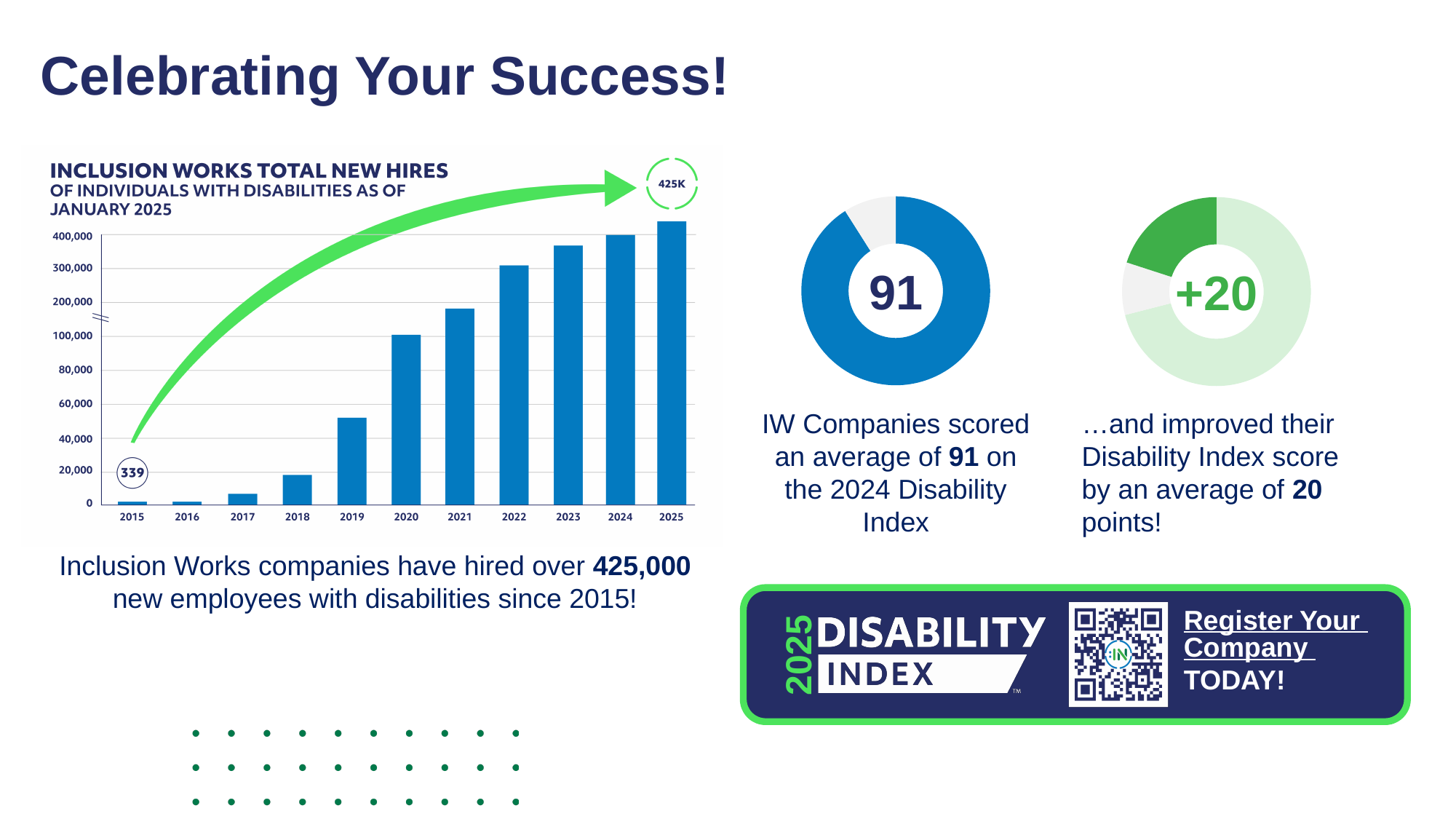
In the 'Inclusion Works Total New Hires' bar chart, is the value for 2018 greater or less than 20,000? less In the 'Inclusion Works Total New Hires' bar chart, what value is labelled for 2015? 339 What number is shown in the centre of the green donut chart on the right of the slide? +20 In the 'Inclusion Works Total New Hires' bar chart, what value is labelled for 2025? 425K In the 'Inclusion Works Total New Hires' bar chart, how many years are shown on the x axis? 11 In the 'Inclusion Works Total New Hires' bar chart, is the value for 2019 greater or less than 40,000? greater In the 'Inclusion Works Total New Hires' bar chart, which year has the lowest number of new hires? 2015 In the 'Inclusion Works Total New Hires' bar chart, which year has the highest number of new hires? 2025 In the 'Inclusion Works Total New Hires' bar chart, do the values rise or fall from 2015 to 2025? Rise What kind of chart is the 'Inclusion Works Total New Hires' chart on the left of the slide? Bar chart In the 'Inclusion Works Total New Hires' bar chart, which is larger, the value for 2020 or the value for 2023? 2023 What number is shown in the centre of the blue donut chart on the right of the slide? 91